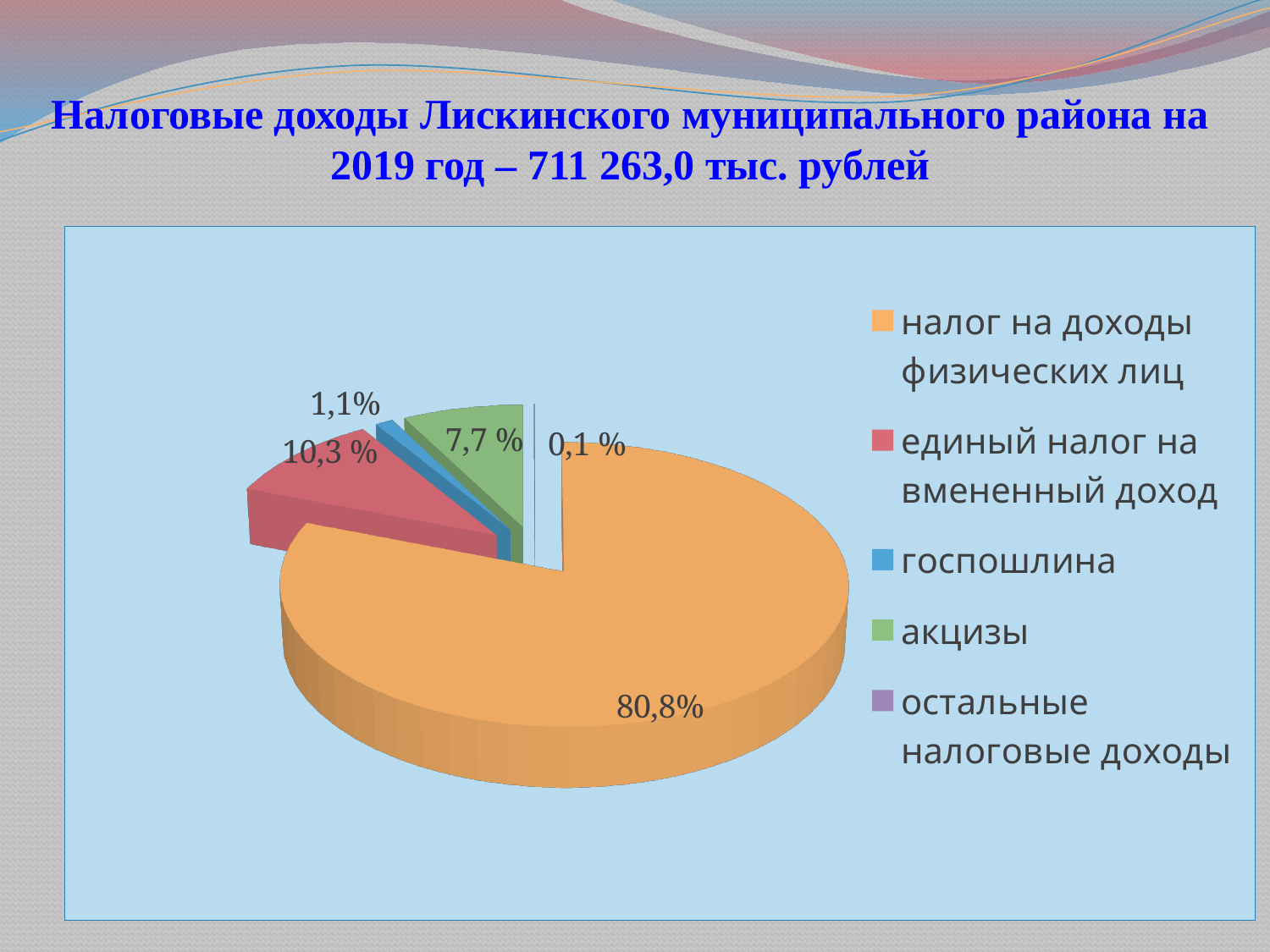
What share of the pie does налог на доходы физических лиц have? 80,8% What share of the pie does остальные налоговые доходы have? 0,1 % What share of the pie does акцизы have? 7,7 % How many categories does the legend list? 5 Which category has the largest slice of the pie? налог на доходы физических лиц Which category has the smallest slice of the pie? остальные налоговые доходы What type of chart is shown on the slide? pie chart Which is larger, the share for акцизы or the share for госпошлина? акцизы What total amount of tax revenue for 2019 is stated in the slide title? 711 263,0 тыс. рублей What is the difference in percentage points between единый налог на вмененный доход and акцизы? 2,6